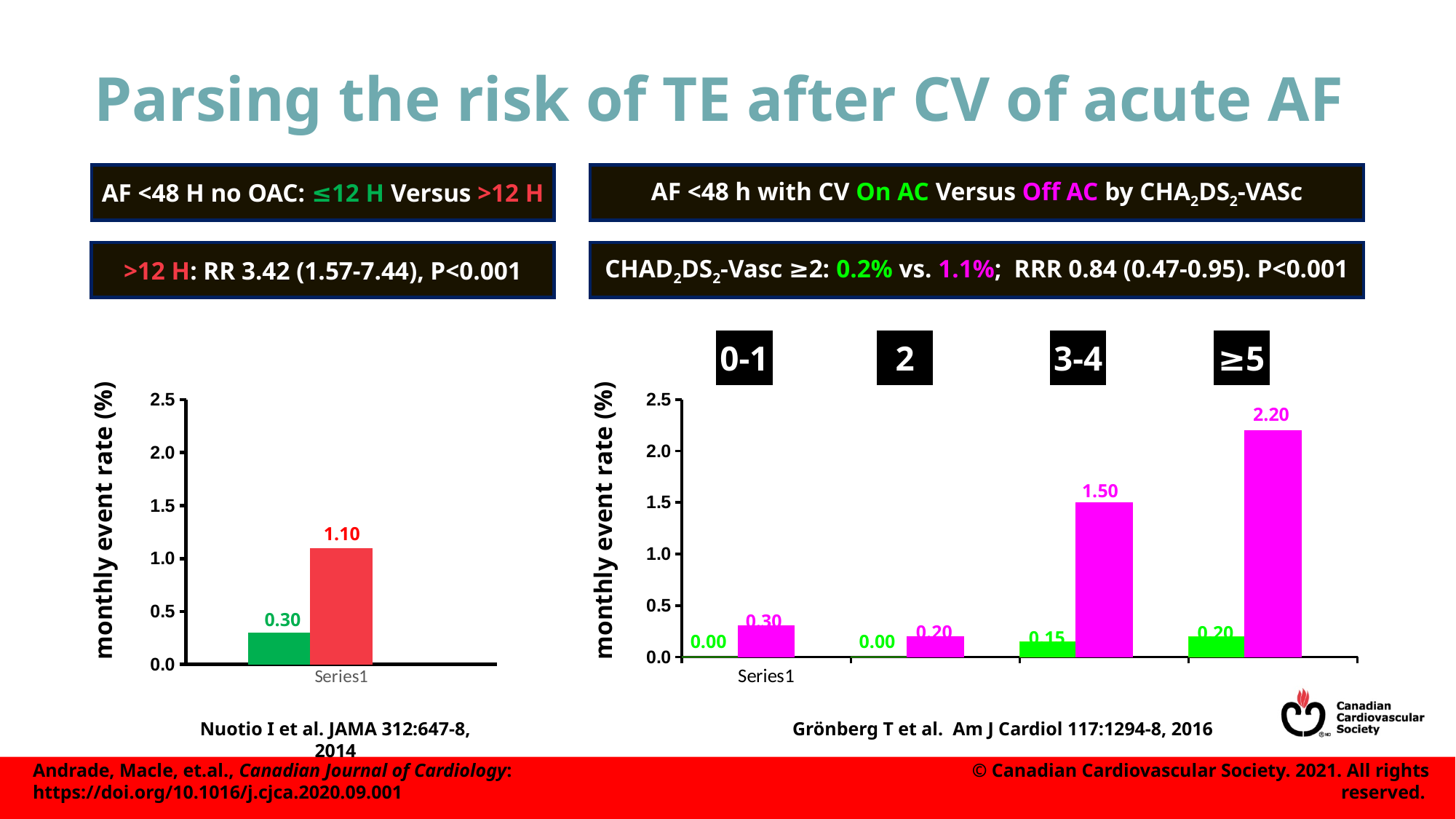
In the right chart (by CHA2DS2-VASc), what is the Off AC (magenta) monthly event rate for the ≥5 group? 2.20 What type of chart is the left chart (AF <48 H no OAC)? Bar chart In the left chart (AF <48 H no OAC), what is the monthly event rate for the ≤12 H (green) bar? 0.30 In the right chart (by CHA2DS2-VASc), how many CHA2DS2-VASc groups are shown? 4 In the right chart (by CHA2DS2-VASc), what is the Off AC (magenta) monthly event rate for the 0-1 group? 0.30 In the right chart (by CHA2DS2-VASc), is the Off AC (magenta) value for the ≥5 group greater or less than 2.0? greater In the left chart (AF <48 H no OAC), what is the difference between the >12 H and ≤12 H monthly event rates? 0.80 In the left chart (AF <48 H no OAC), what is the monthly event rate for the >12 H (red) bar? 1.10 In the left chart (AF <48 H no OAC), which bar is higher, ≤12 H or >12 H? >12 H In the right chart (by CHA2DS2-VASc), what is the difference between the Off AC and On AC monthly event rates in the 3-4 group? 1.35 In the right chart (by CHA2DS2-VASc), what is the On AC (green) monthly event rate for the 3-4 group? 0.15 In the right chart (by CHA2DS2-VASc), which CHA2DS2-VASc group has the highest Off AC (magenta) monthly event rate? ≥5